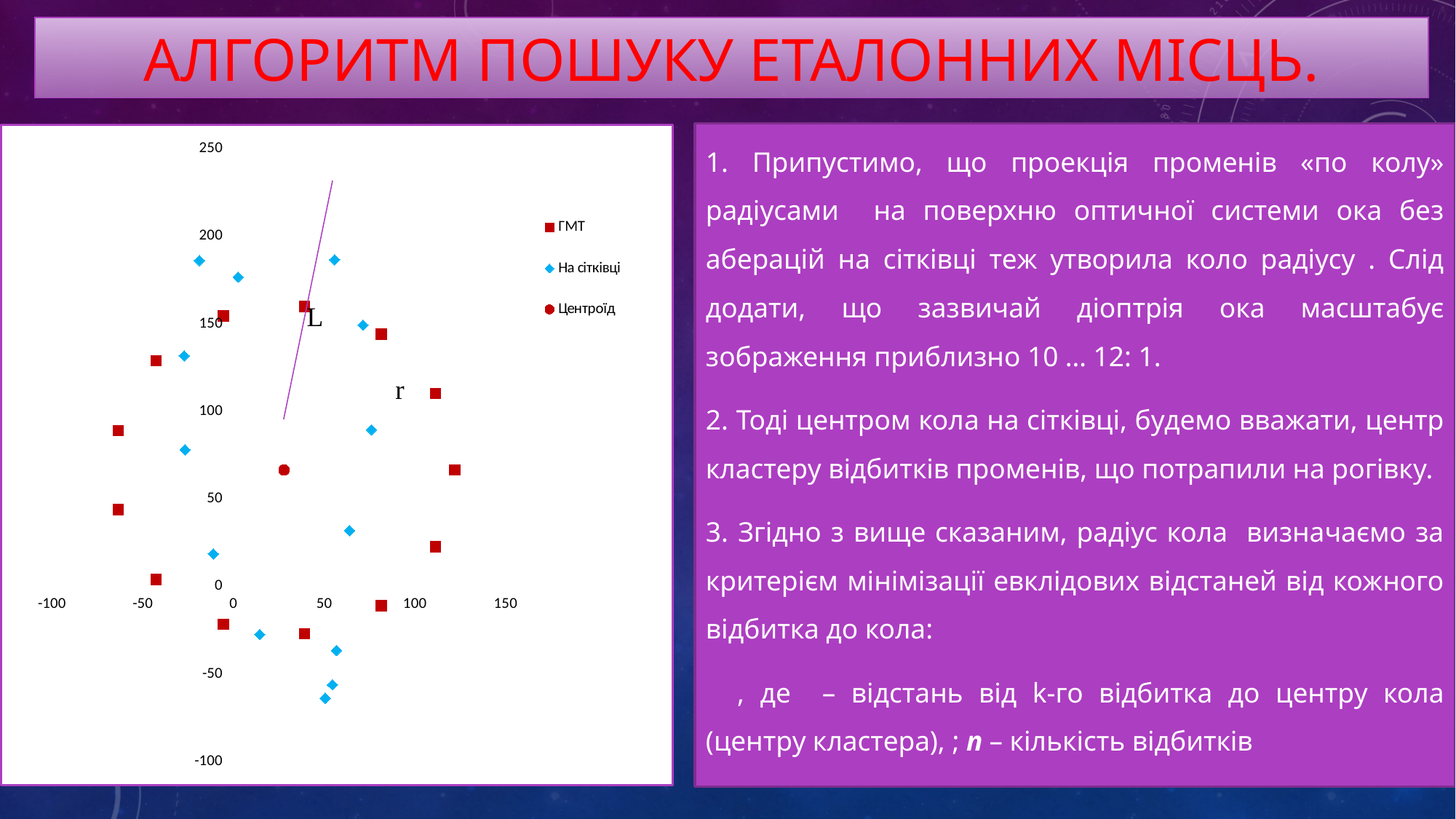
How many series does the chart legend list? 3 What kind of chart is shown on the left of the slide? scatter chart How many points does the Центроїд series have on the chart? 1 Is the x-value of the Центроїд point greater or less than 50? less Which series in the chart is drawn with blue diamond markers? На сітківці Is the y-value of the Центроїд point greater or less than 100? less Is the y-value of the Центроїд point greater or less than 50? greater What are the three series named in the chart legend? ГМТ, На сітківці, Центроїд What is the highest tick value shown on the vertical axis of the chart? 250